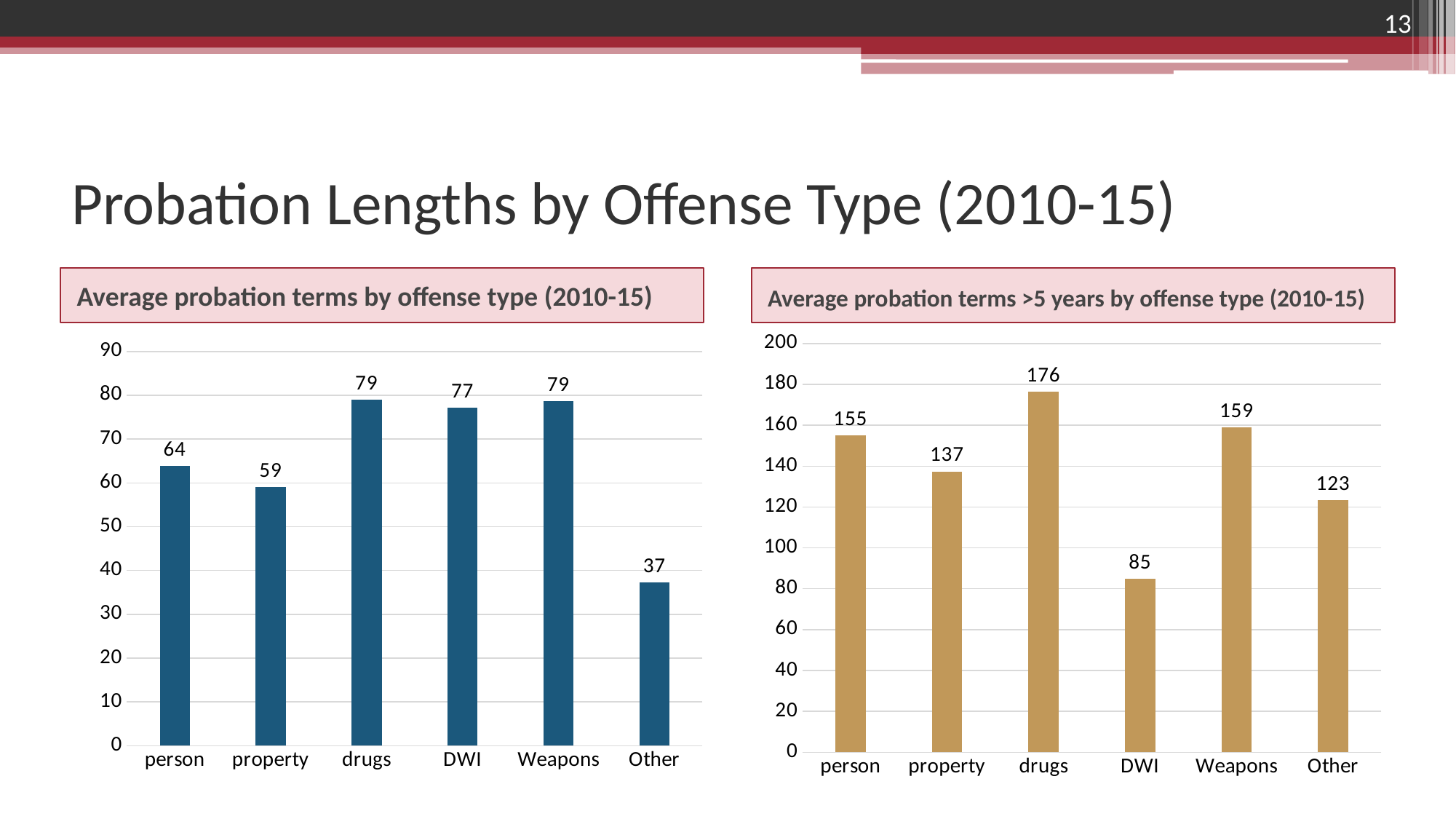
In the left chart (Average probation terms by offense type), what is the difference between the values for person and property? 5 What is the title of the left chart? Average probation terms by offense type (2010-15) How many offense types are shown in the left chart (Average probation terms by offense type)? 6 In the right chart (Average probation terms >5 years by offense type), which offense type has the lowest value? DWI What kind of chart is the right chart (Average probation terms >5 years by offense type)? bar chart In the right chart (Average probation terms >5 years by offense type), which is larger, the value for person or the value for property? person In the left chart (Average probation terms by offense type), what is the value for DWI? 77 In the right chart (Average probation terms >5 years by offense type), what is the value for Weapons? 159 In the right chart (Average probation terms >5 years by offense type), what is the difference between the values for drugs and DWI? 91 In the left chart (Average probation terms by offense type), is the value for Other greater or less than 40? less In the right chart (Average probation terms >5 years by offense type), which offense type has the highest value? drugs In the left chart (Average probation terms by offense type), which offense type has the lowest value? Other